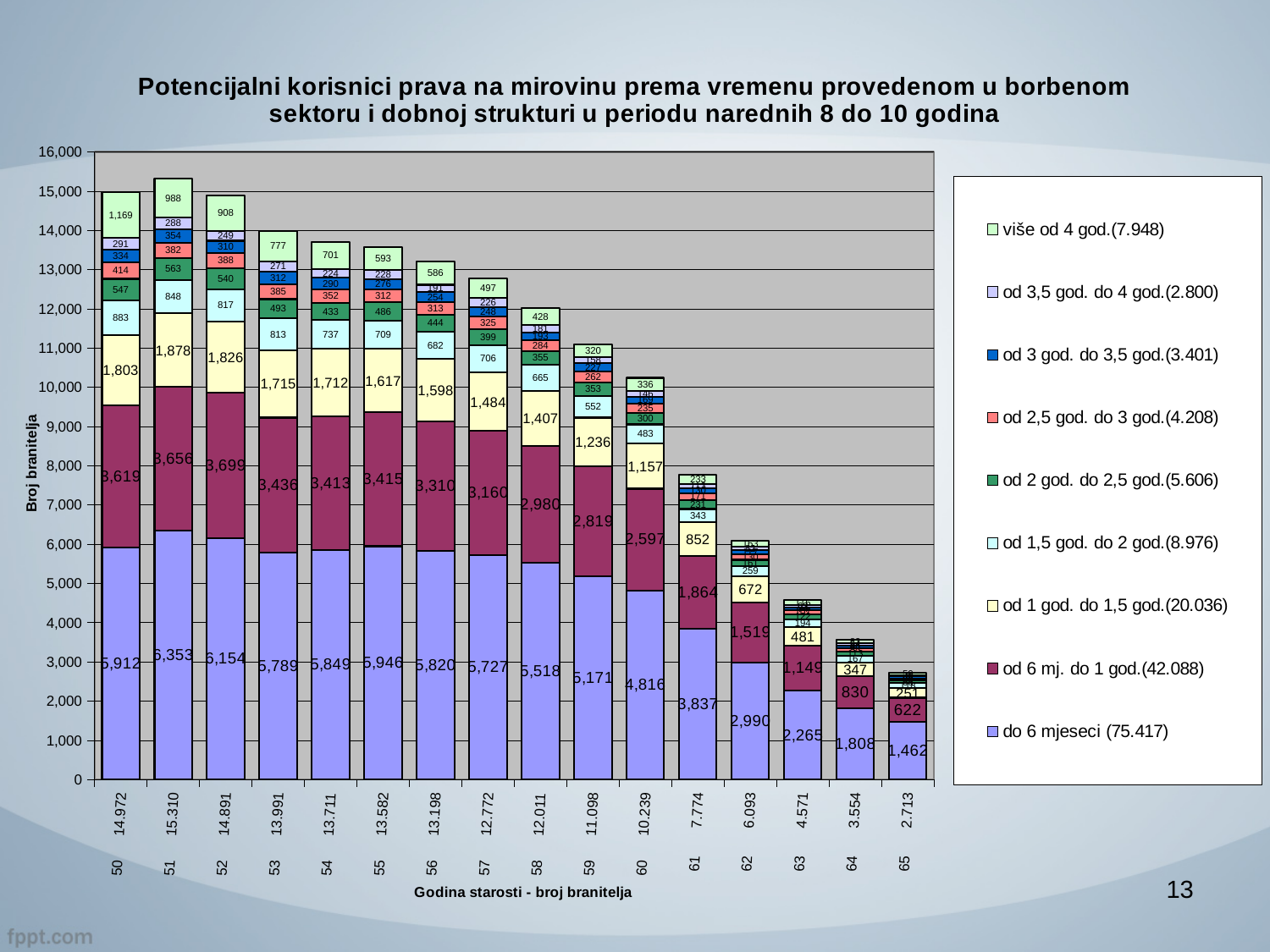
Which age has the larger 'od 1 god. do 1,5 god.' value, 50 or 51? 51 How many age categories are plotted along the x axis? 16 What is the value of the 'od 6 mj. do 1 god.' segment for age 52? 3,699 What kind of chart is shown on the slide? Stacked bar chart How many series does the legend list? 9 Do the bar totals rise or fall from age 60 to age 65? Fall What is the difference between the 'do 6 mjeseci' values for age 50 and age 65? 4,450 What is the value of the 'više od 4 god.' segment for age 50? 1,169 Which age has the highest total number of branitelji? 51 What is the total shown for the age 58 bar? 12.011 Which age has the lowest total number of branitelji? 65 What is the value of the 'do 6 mjeseci' segment for age 51? 6,353